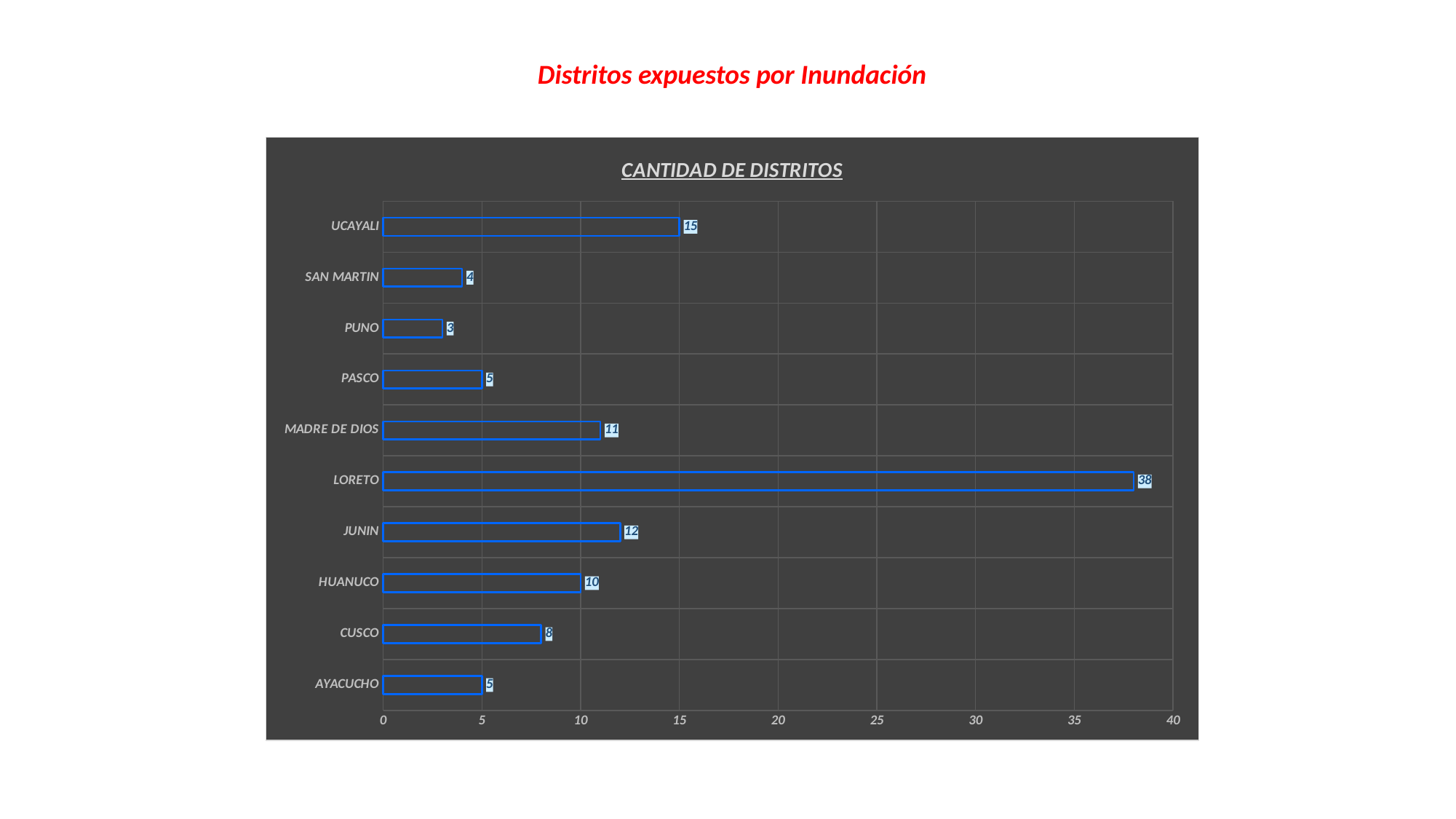
Which category has the highest value? LORETO How many categories are shown on the chart? 10 What is the value for UCAYALI? 15 What is the value for LORETO? 38 What is the title of the chart? CANTIDAD DE DISTRITOS What is the difference between the values for JUNIN and HUANUCO? 2 What kind of chart is shown? bar chart What is the difference between the values for LORETO and UCAYALI? 23 Is the value for LORETO greater or less than 35? greater Which is larger, the value for CUSCO or the value for SAN MARTIN? CUSCO Which category has the lowest value? PUNO What is the value for MADRE DE DIOS? 11